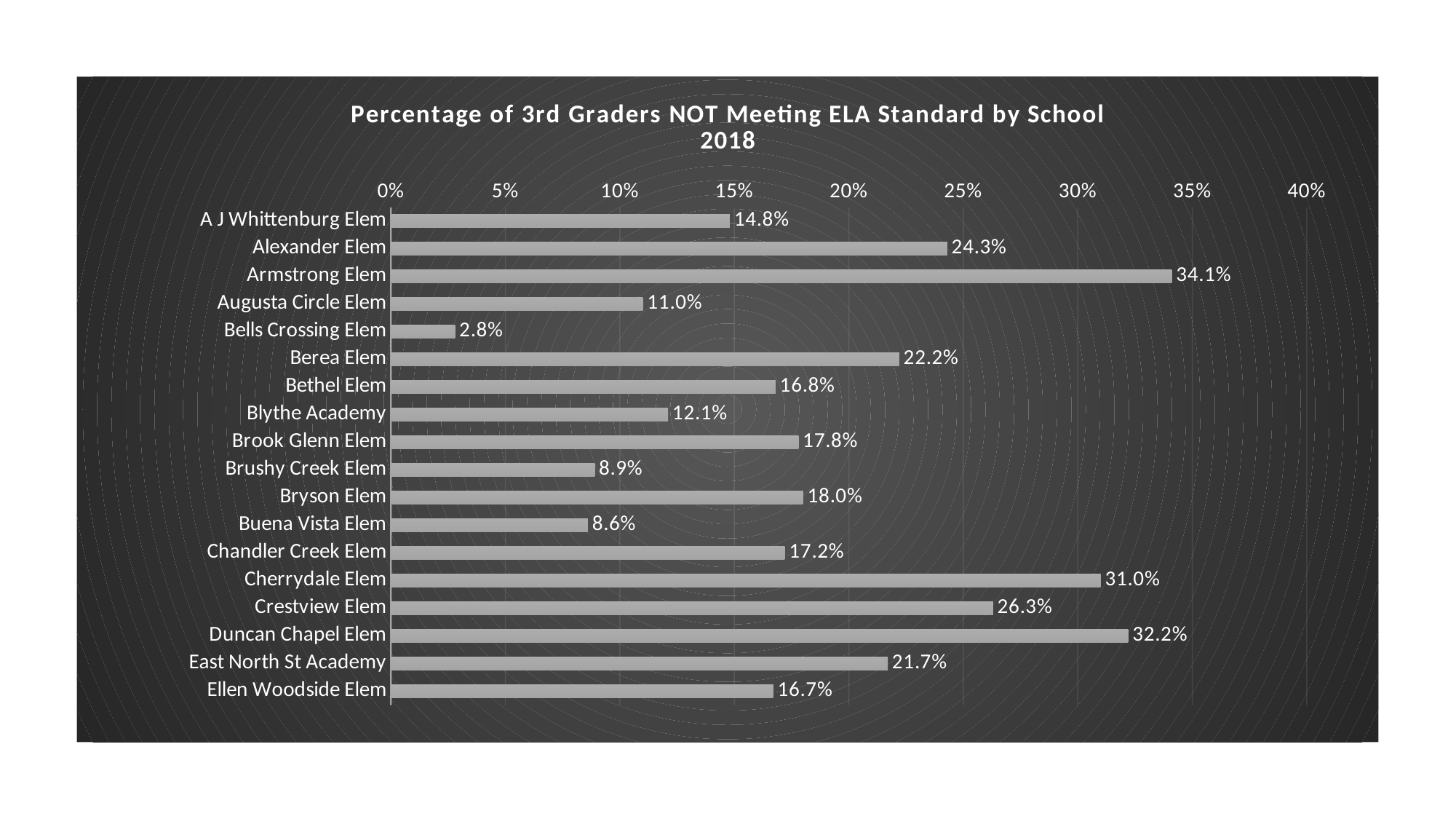
What is the value shown for East North St Academy? 21.7% What is the title of the chart? Percentage of 3rd Graders NOT Meeting ELA Standard by School 2018 What is the value shown for Bells Crossing Elem? 2.8% Which school has the lowest percentage of 3rd graders not meeting the ELA standard? Bells Crossing Elem Is the value for Berea Elem greater or less than 20%? greater What kind of chart is shown on the slide? Bar chart Which has a higher value, Alexander Elem or Crestview Elem? Crestview Elem What percentage of 3rd graders at Armstrong Elem did not meet the ELA standard? 34.1% Which school has the highest percentage of 3rd graders not meeting the ELA standard? Armstrong Elem How many schools are shown in the chart? 18 What is the difference between the values for Duncan Chapel Elem and Cherrydale Elem? 1.2% What is the maximum value shown on the horizontal axis? 40%